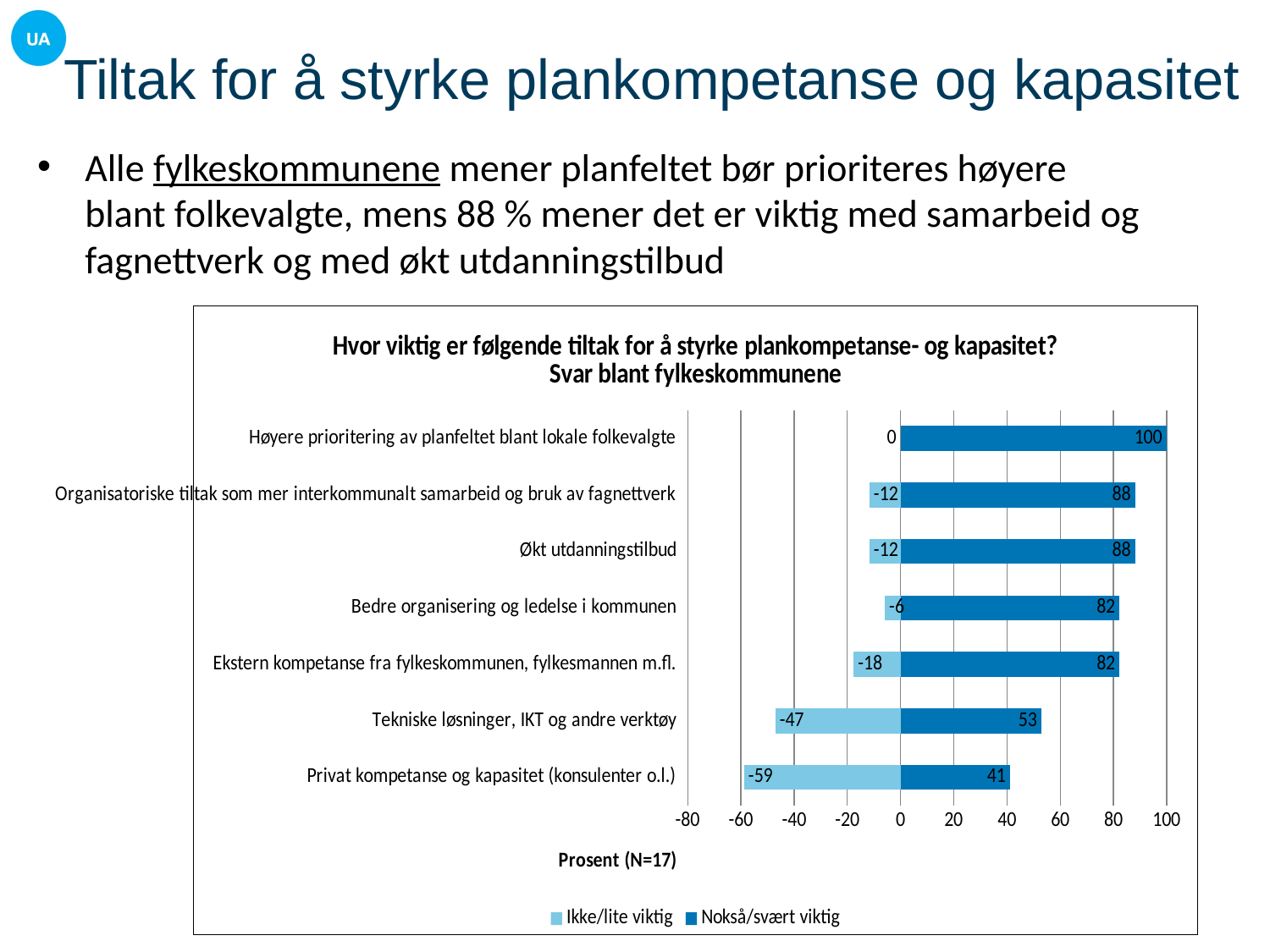
What is the 'Ikke/lite viktig' value for 'Privat kompetanse og kapasitet (konsulenter o.l.)'? -59 Which category has the lowest 'Nokså/svært viktig' value? Privat kompetanse og kapasitet (konsulenter o.l.) Which category has the highest 'Nokså/svært viktig' value? Høyere prioritering av planfeltet blant lokale folkevalgte Which has a larger 'Nokså/svært viktig' value: 'Bedre organisering og ledelse i kommunen' or 'Privat kompetanse og kapasitet (konsulenter o.l.)'? Bedre organisering og ledelse i kommunen What is the difference between the 'Nokså/svært viktig' values for 'Økt utdanningstilbud' and 'Tekniske løsninger, IKT og andre verktøy'? 35 What is the 'Ikke/lite viktig' value for 'Ekstern kompetanse fra fylkeskommunen, fylkesmannen m.fl.'? -18 What type of chart is shown on the slide? bar chart How many categories (tiltak) are plotted in the chart? 7 How many series does the legend list? 2 What is the x-axis title of the chart? Prosent (N=17) What is the 'Nokså/svært viktig' value for 'Tekniske løsninger, IKT og andre verktøy'? 53 What is the 'Nokså/svært viktig' value for 'Høyere prioritering av planfeltet blant lokale folkevalgte'? 100